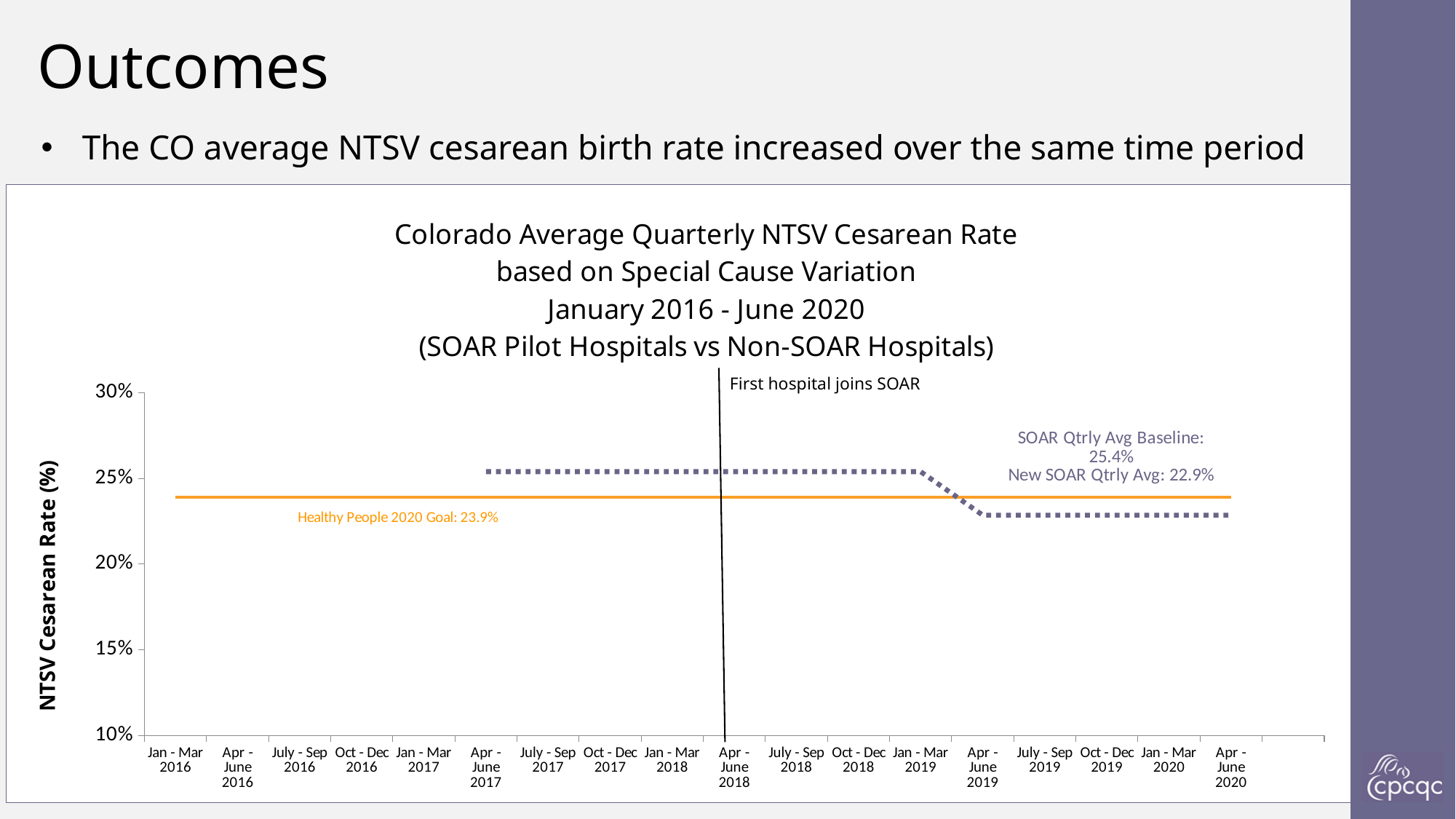
Is the new SOAR quarterly average greater or less than 25%? less Which is larger, the new SOAR quarterly average or the Healthy People 2020 Goal? Healthy People 2020 Goal What is the new SOAR quarterly average shown on the chart? 22.9% Which is larger, the SOAR quarterly average baseline or the Healthy People 2020 Goal? SOAR quarterly average baseline Does the dotted SOAR quarterly average line rise or fall from left to right across the chart? fall What is the SOAR quarterly average baseline value shown on the chart? 25.4% What event does the vertical line on the chart mark? First hospital joins SOAR By how many percentage points does the SOAR quarterly average baseline exceed the new SOAR quarterly average? 2.5 percentage points What kind of chart is shown on the slide? line chart How many quarters are labelled along the x axis of the chart? 18 What is the label on the y axis of the chart? NTSV Cesarean Rate (%) What is the Healthy People 2020 Goal value shown on the chart? 23.9%